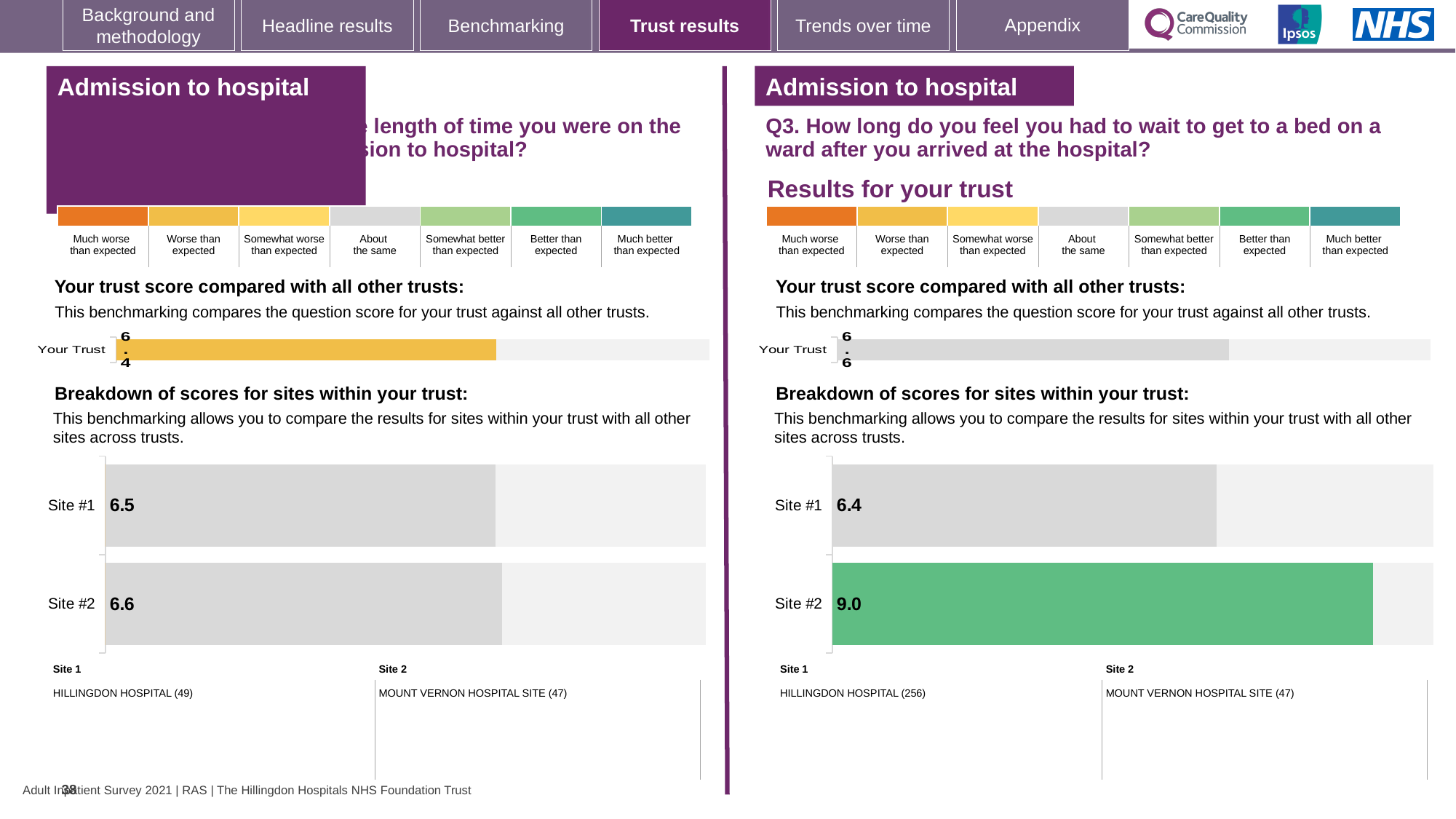
On the left-hand site breakdown chart, what is the score for Site #1? 6.5 What type of chart is used for the site breakdown on the right-hand (Q3) side of the slide? Bar chart On the right-hand (Q3) site breakdown chart, what is the score for Site #2? 9.0 How many sites are shown on the right-hand (Q3) site breakdown chart? 2 On the right-hand (Q3) site breakdown chart, what is the difference between the Site #2 and Site #1 scores? 2.6 On the right-hand (Q3) site breakdown chart, what colour is the bar for Site #2? Green On the right-hand (Q3) site breakdown chart, what is the score for Site #1? 6.4 On the left-hand 'Your trust score compared with all other trusts' chart, what is the score shown for Your Trust? 6.4 On the right-hand (Q3) site breakdown chart, which site has the higher score? Site #2 On the left-hand site breakdown chart, what is the difference between the Site #2 and Site #1 scores? 0.1 On the right-hand (Q3) 'Your trust score compared with all other trusts' chart, what is the score shown for Your Trust? 6.6 On the left-hand site breakdown chart, what is the score for Site #2? 6.6